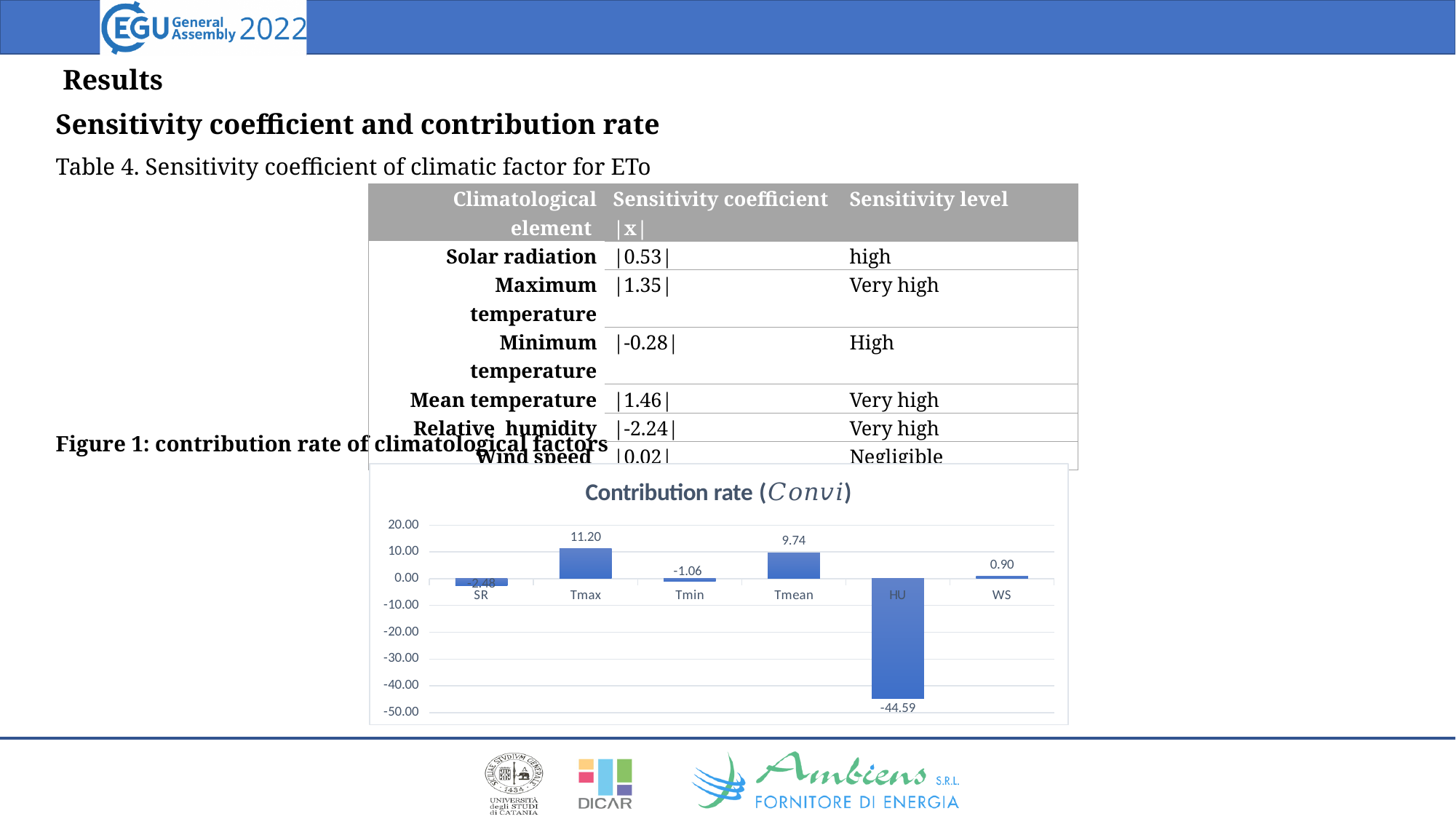
What is the contribution rate value for Tmean? 9.74 What is the contribution rate value for WS? 0.90 Is the value for SR greater or less than 0.00? less What is the contribution rate value for Tmax? 11.20 What type of chart is shown on the slide? bar chart How many categories are shown in the chart? 6 Which category has the lowest contribution rate? HU What is the contribution rate value for HU? -44.59 What is the difference between the contribution rates of Tmax and Tmean? 1.46 Which category has the highest contribution rate? Tmax Which has a larger contribution rate, Tmax or Tmean? Tmax What is the contribution rate value for Tmin? -1.06